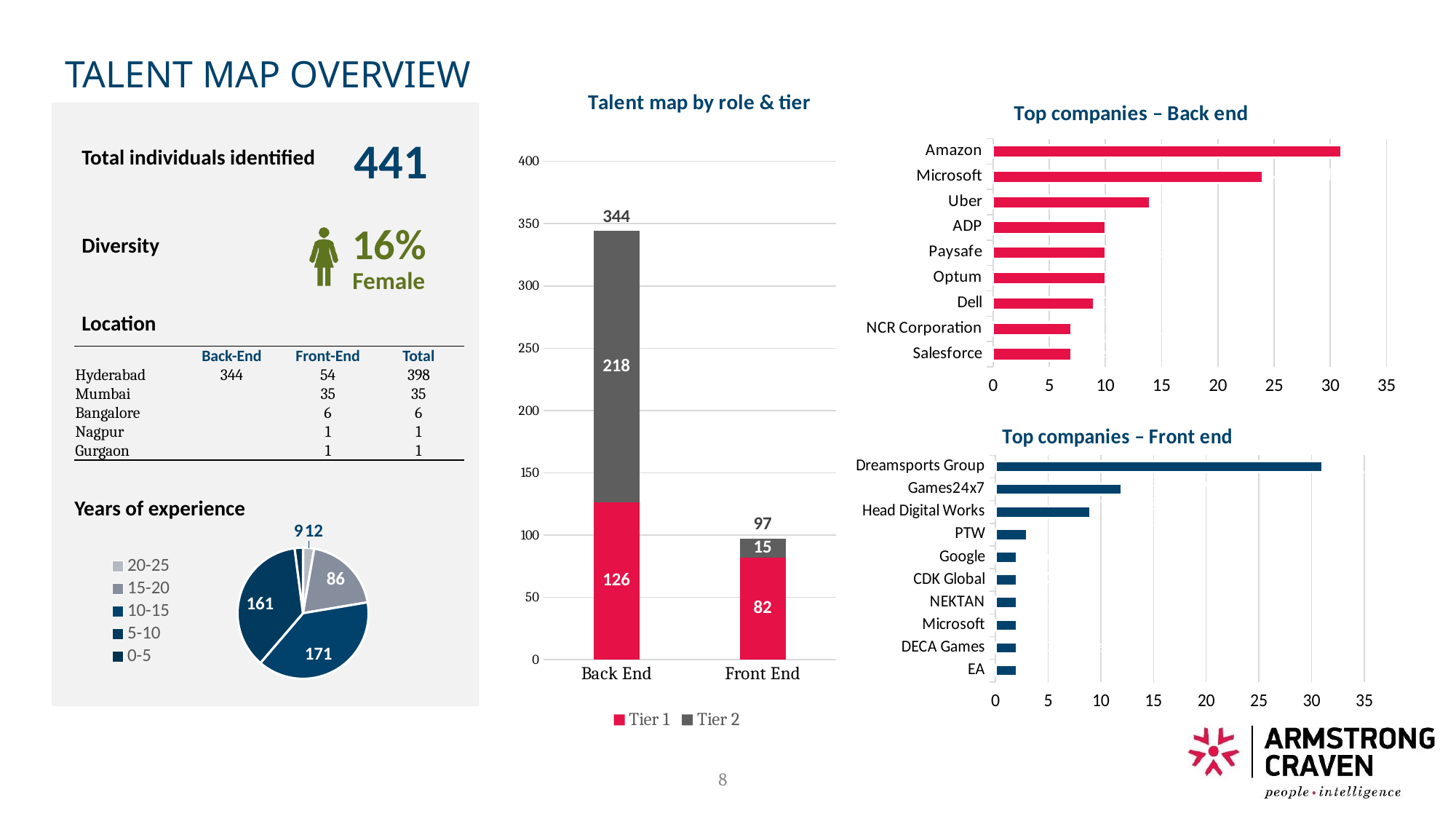
In the 'Talent map by role & tier' chart, what is the total of the Back End stacked bar? 344 In the 'Talent map by role & tier' chart, what is the Tier 1 value for Front End? 82 In the 'Top companies – Front end' chart, is the value for Head Digital Works greater or less than 10? less In the 'Top companies – Back end' chart, is the value for Microsoft greater or less than 20? greater In the 'Talent map by role & tier' chart, what is the difference between the Back End total and the Front End total? 247 In the 'Talent map by role & tier' chart, how many series does the legend list? 2 In the 'Top companies – Back end' chart, which company has the highest value? Amazon In the 'Years of experience' chart, what is the value of the largest slice? 171 In the 'Top companies – Front end' chart, which company has the highest value? Dreamsports Group In the 'Talent map by role & tier' chart, what is the Tier 2 value for Back End? 218 In the 'Top companies – Back end' chart, how many companies are shown? 9 In the 'Top companies – Front end' chart, how many companies are shown? 10